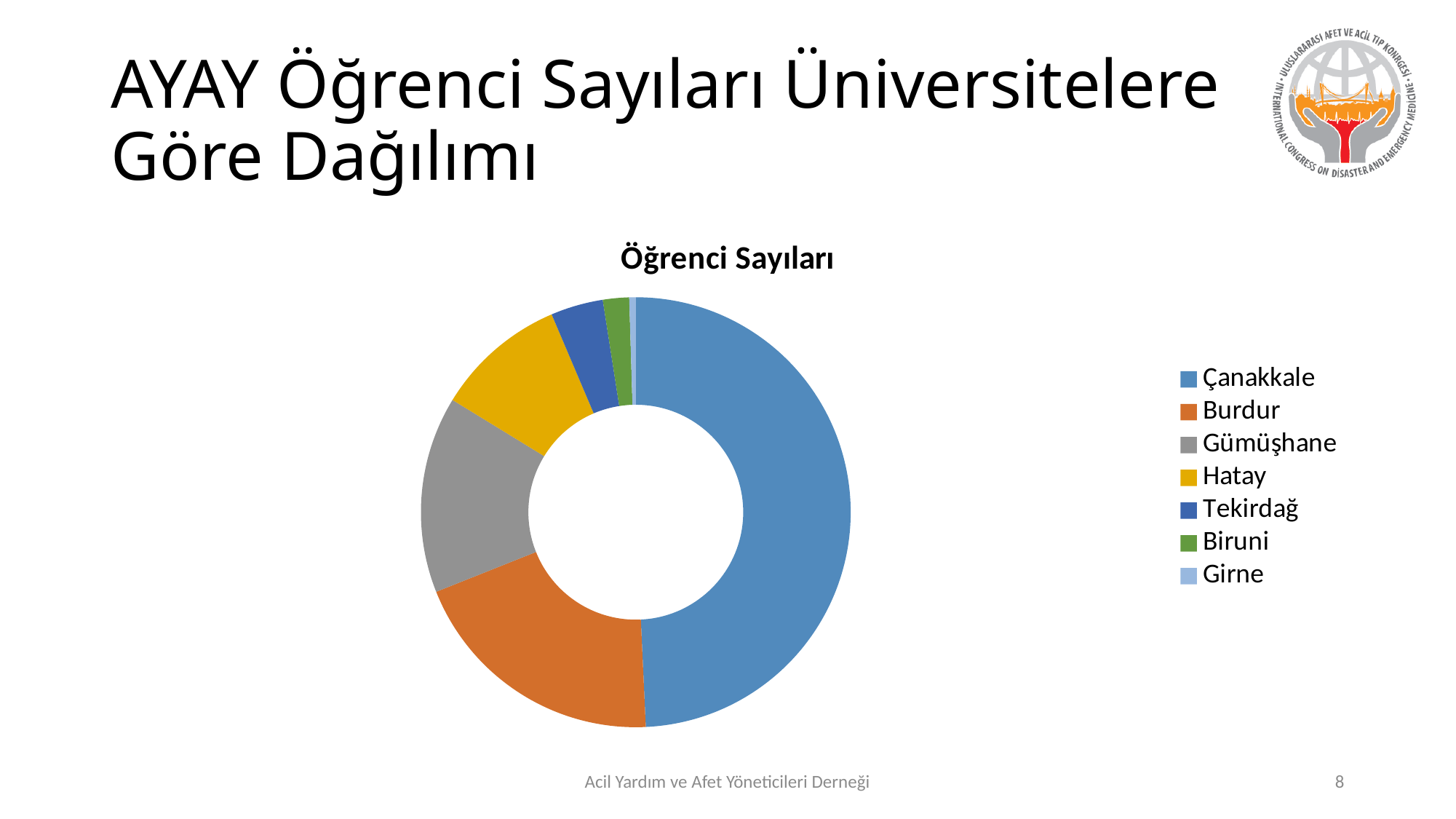
What is the title of the chart? Öğrenci Sayıları Which slice is larger, Burdur or Hatay? Burdur Which slice is larger, Tekirdağ or Girne? Tekirdağ How many categories does the chart's legend list? 7 Which category has the smallest slice in the chart? Girne Which slice is larger, Çanakkale or Burdur? Çanakkale What kind of chart is shown on the slide? doughnut chart Which category is shown in orange in the chart? Burdur Which category has the largest slice in the chart? Çanakkale